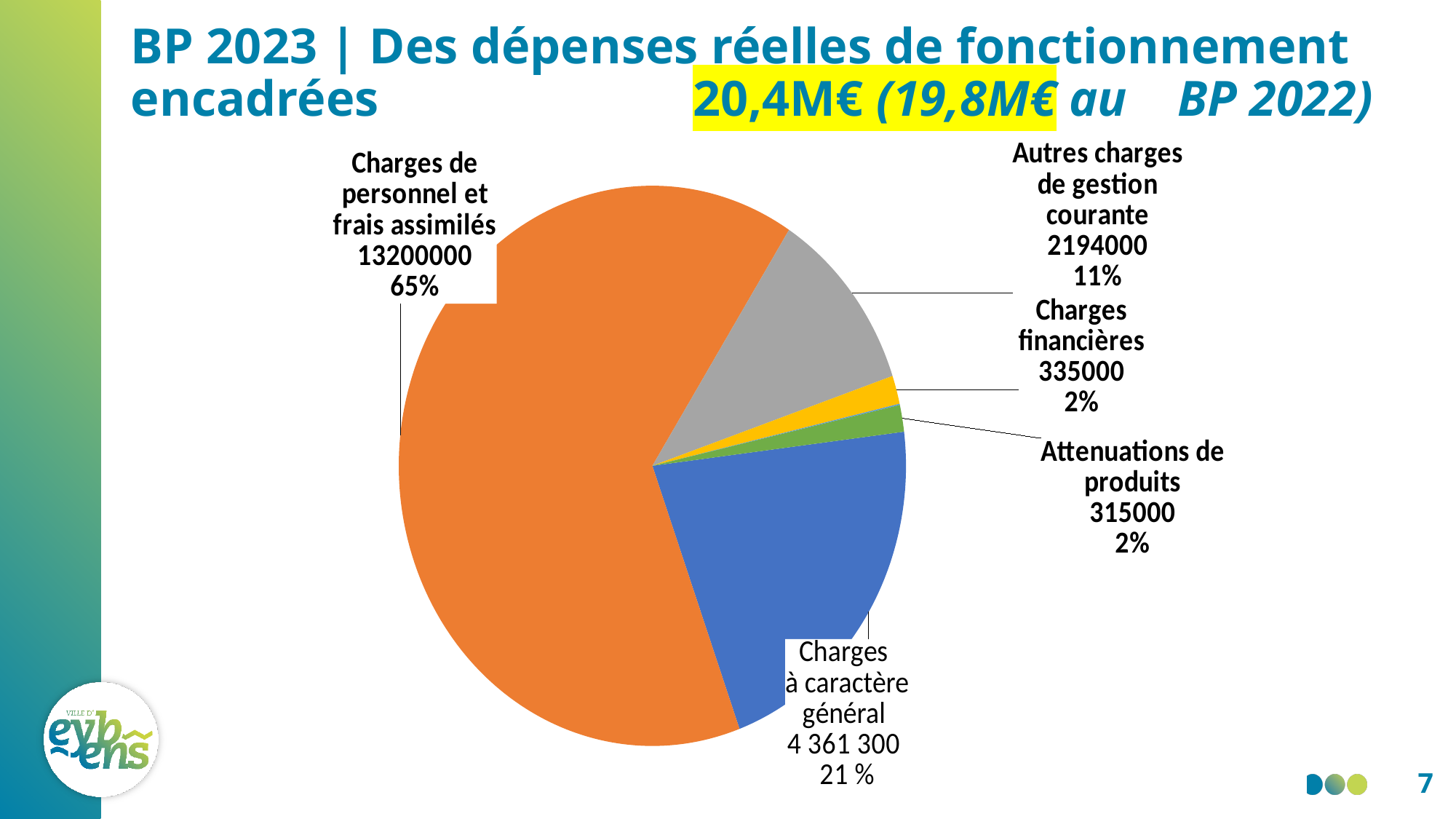
What kind of chart is shown on the slide? pie chart What share of the pie does Charges de personnel et frais assimilés represent? 65% What is the difference between the values for Charges financières and Attenuations de produits? 20000 Which category has the largest slice of the pie? Charges de personnel et frais assimilés What colour is the slice for Charges à caractère général? blue What is the value shown for Charges de personnel et frais assimilés? 13200000 Which is larger, Autres charges de gestion courante or Charges à caractère général? Charges à caractère général What is the value shown for Autres charges de gestion courante? 2194000 What share of the pie does Charges à caractère général represent? 21 % What is the value shown for Charges financières? 335000